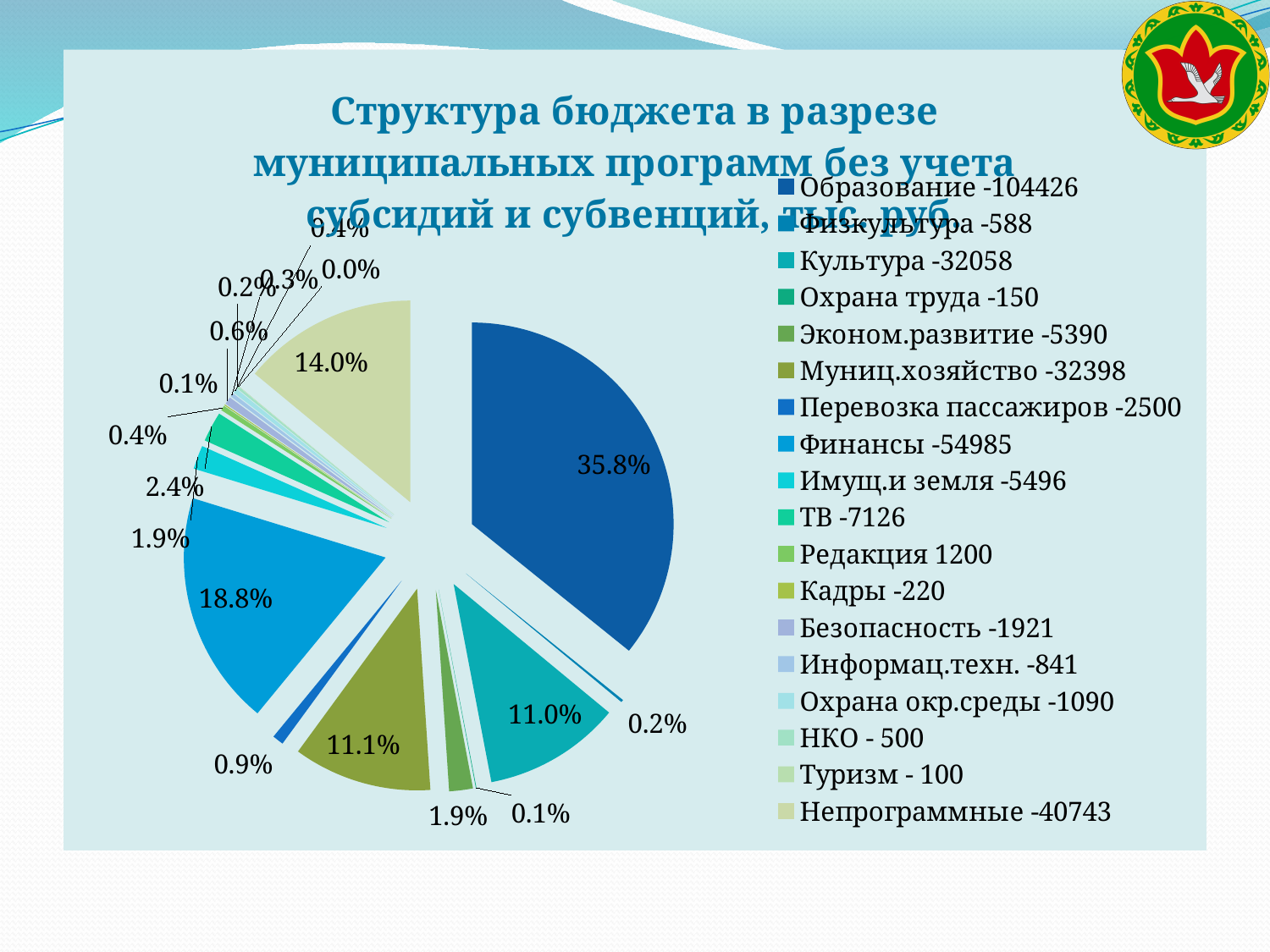
What kind of chart is shown on the slide? pie chart Which category has the largest share of the pie? Образование What share of the pie does Финансы take? 18.8% Which is larger, the share for Финансы or the share for Непрограммные? Финансы What is the difference between the legend values for Образование and Финансы? 49441 What value is shown for Муниц.хозяйство in the legend? 32398 What share of the pie does Образование take? 35.8% How many categories does the legend of the pie chart list? 18 What value is shown for Образование in the legend? 104426 What value is shown for Туризм in the legend? 100 What share of the pie does Непрограммные take? 14.0% Which category has the smallest value in the legend? Туризм